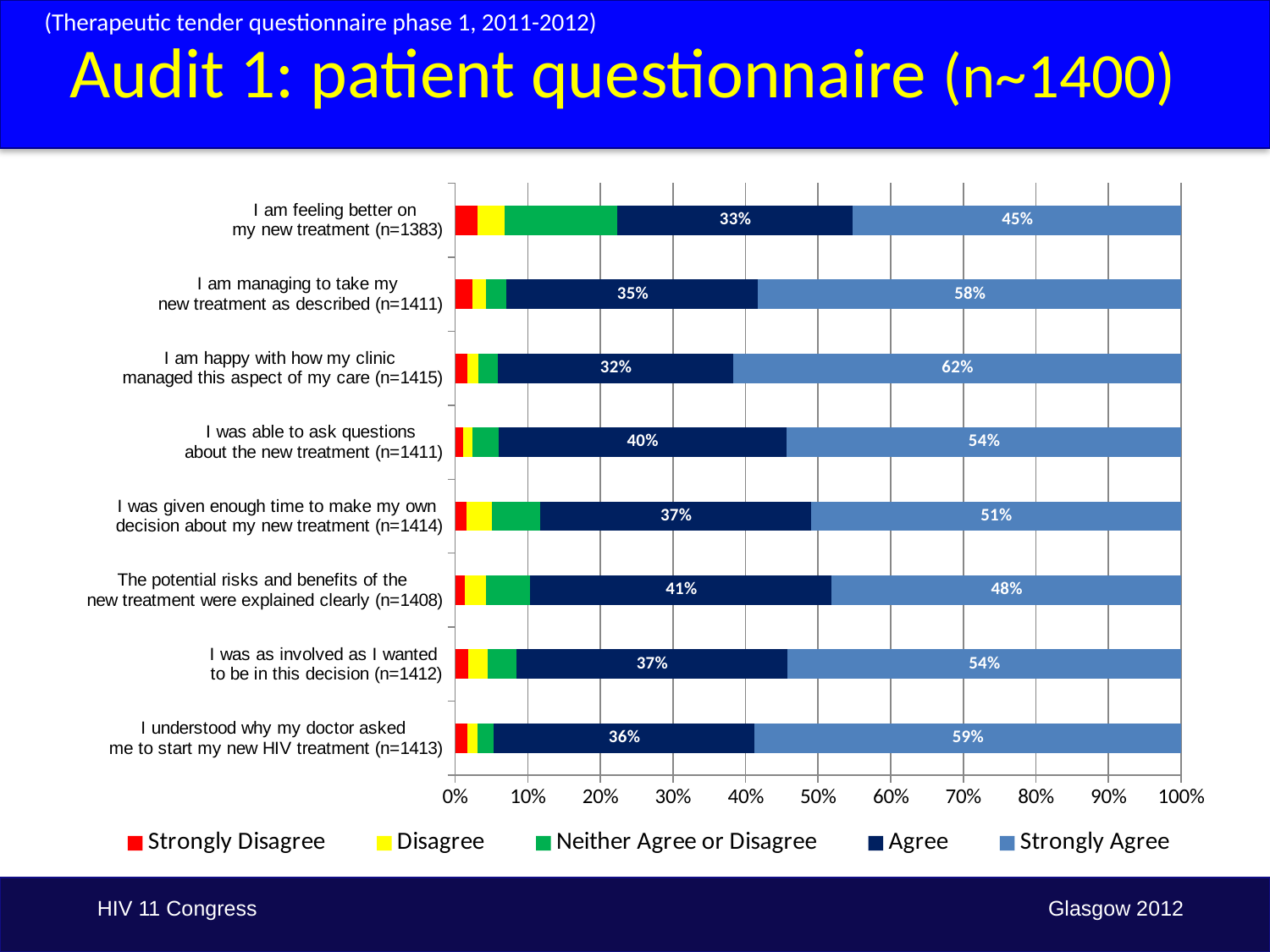
Which statement has the highest 'Strongly Agree' percentage? I am happy with how my clinic managed this aspect of my care What is the combined percentage of 'Agree' and 'Strongly Agree' for 'I understood why my doctor asked me to start my new HIV treatment'? 95% Is the 'Neither Agree or Disagree' share for 'I am feeling better on my new treatment' greater or less than 10%? greater What percentage of patients answered 'Strongly Agree' to 'I am feeling better on my new treatment'? 45% How many statements are shown in the chart? 8 Which statement has the lowest 'Strongly Agree' percentage? I am feeling better on my new treatment What percentage of patients answered 'Agree' to 'The potential risks and benefits of the new treatment were explained clearly'? 41% Which statement has the lowest 'Agree' percentage? I am happy with how my clinic managed this aspect of my care What is the difference in percentage points between the 'Strongly Agree' and 'Agree' values for 'I am happy with how my clinic managed this aspect of my care'? 30 percentage points What percentage of patients answered 'Strongly Agree' to 'I am happy with how my clinic managed this aspect of my care'? 62% Which is larger: the 'Strongly Agree' percentage for 'I am managing to take my new treatment as described' or for 'I was given enough time to make my own decision about my new treatment'? I am managing to take my new treatment as described How many response categories does the legend list? 5